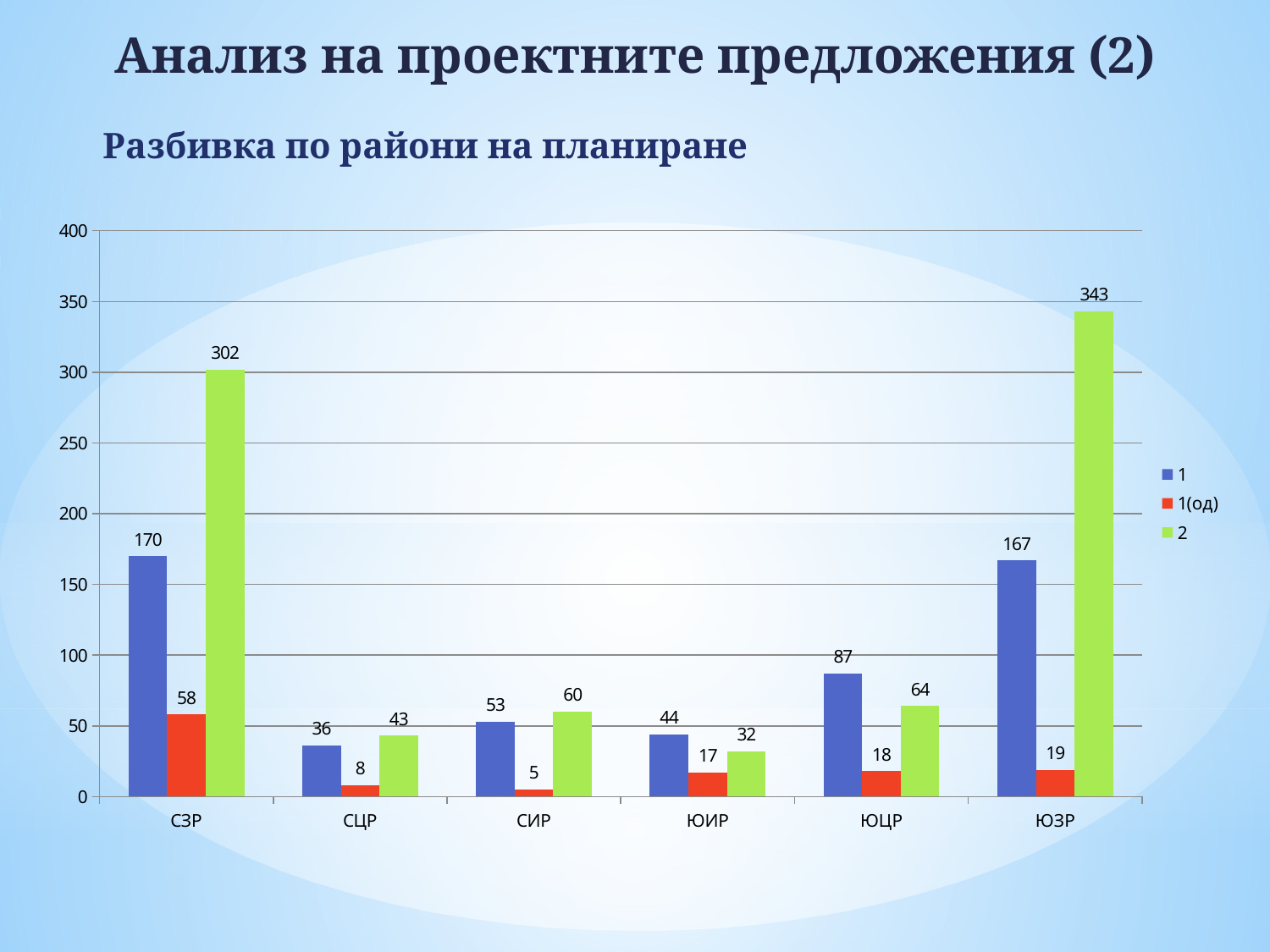
What kind of chart is shown on the slide? bar chart What is the value of series 1 for ЮЦР? 87 Is the value of series 2 for СЗР greater or less than 250? greater What is the difference between the series 2 values for ЮЗР and СЗР? 41 Which category has the highest value for series 2? ЮЗР What is the value of series 2 for ЮЗР? 343 Which is larger for ЮИР: series 1 or series 2? series 1 Which category has the lowest value for series 1(од)? СИР How many series does the legend list? 3 What is the value of series 1(од) for СИР? 5 How many categories are shown on the x axis? 6 What colour are the bars for series 1(од)? red